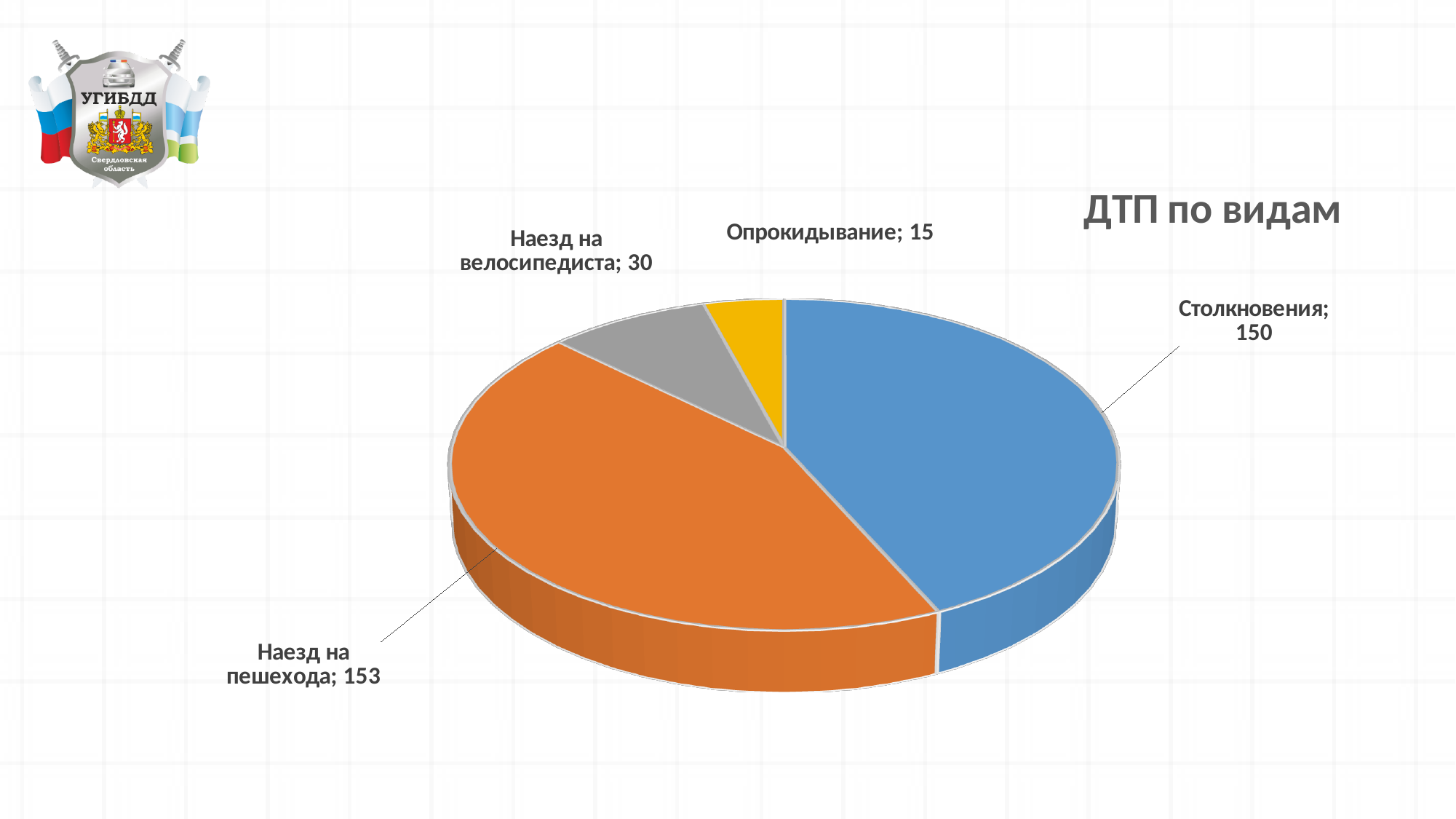
What is the difference between Наезд на пешехода and Столкновения? 3 Which is larger, Наезд на велосипедиста or Опрокидывание? Наезд на велосипедиста What is the title of the chart? ДТП по видам Which category has the lowest value? Опрокидывание What is the value for Наезд на пешехода? 153 What is the value for Наезд на велосипедиста? 30 What is the value for Опрокидывание? 15 How many categories does the pie chart show? 4 What is the value for Столкновения? 150 What kind of chart is shown on the slide? Pie chart Which category has the highest value? Наезд на пешехода What is the difference between Наезд на велосипедиста and Опрокидывание? 15